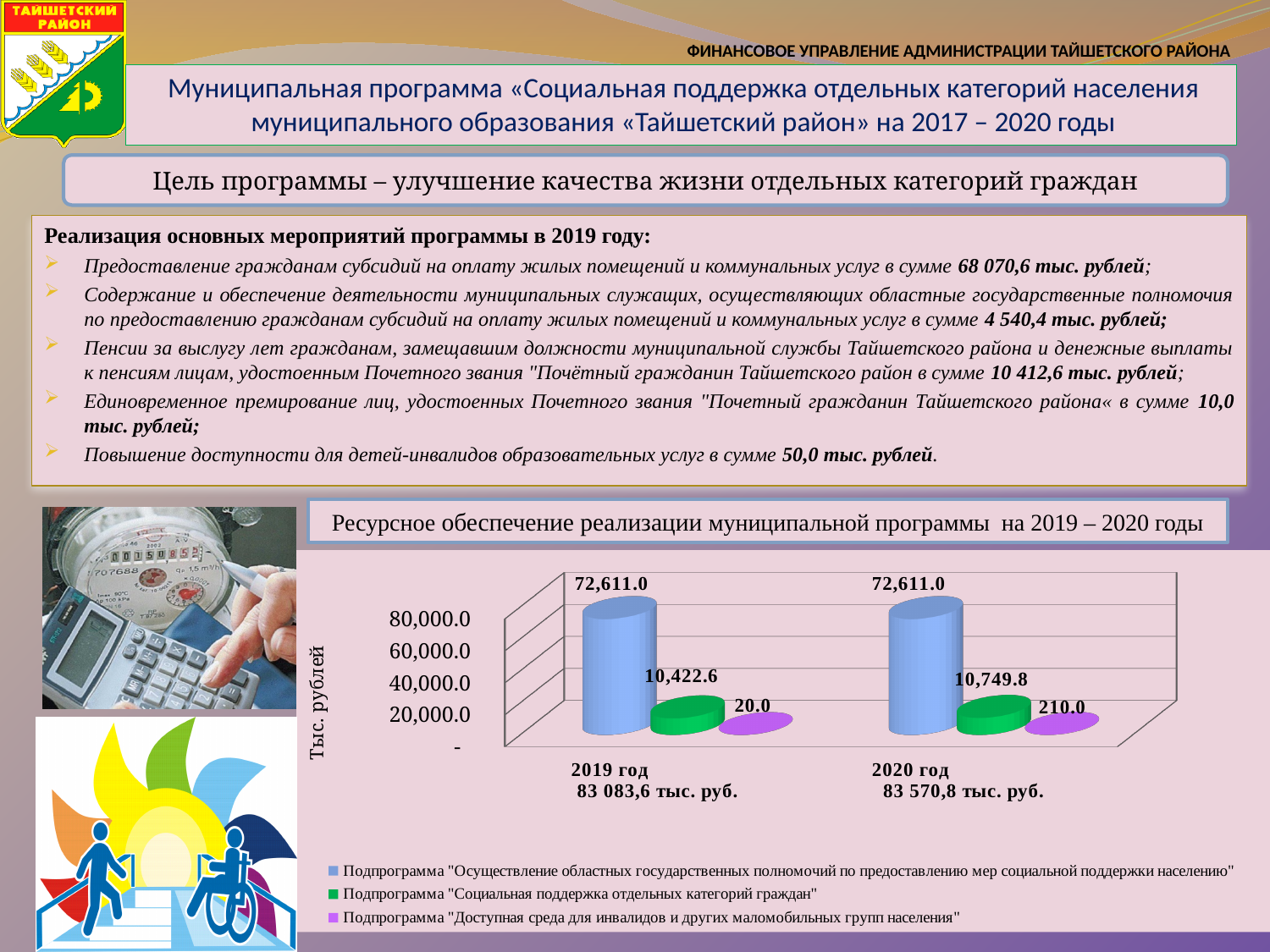
How many series does the legend list? 3 What is the value for the subprogram "Социальная поддержка отдельных категорий граждан" in 2020 год? 10,749.8 What kind of chart is shown on the slide? bar chart How many year categories are shown on the x axis? 2 Which subprogram has the highest value in 2020 год? Подпрограмма "Осуществление областных государственных полномочий по предоставлению мер социальной поддержки населению" Which subprogram has the lowest value in 2019 год? Подпрограмма "Доступная среда для инвалидов и других маломобильных групп населения" Is the value for the subprogram "Социальная поддержка отдельных категорий граждан" in 2019 год larger or smaller than in 2020 год? smaller What is the label of the vertical axis of the chart? Тыс. рублей What is the value for the subprogram "Доступная среда для инвалидов и других маломобильных групп населения" in 2020 год? 210.0 What is the value for the subprogram "Осуществление областных государственных полномочий по предоставлению мер социальной поддержки населению" in 2019 год? 72,611.0 What is the difference between the 2020 год and 2019 год values for the subprogram "Социальная поддержка отдельных категорий граждан"? 327.2 What is the value for the subprogram "Доступная среда для инвалидов и других маломобильных групп населения" in 2019 год? 20.0